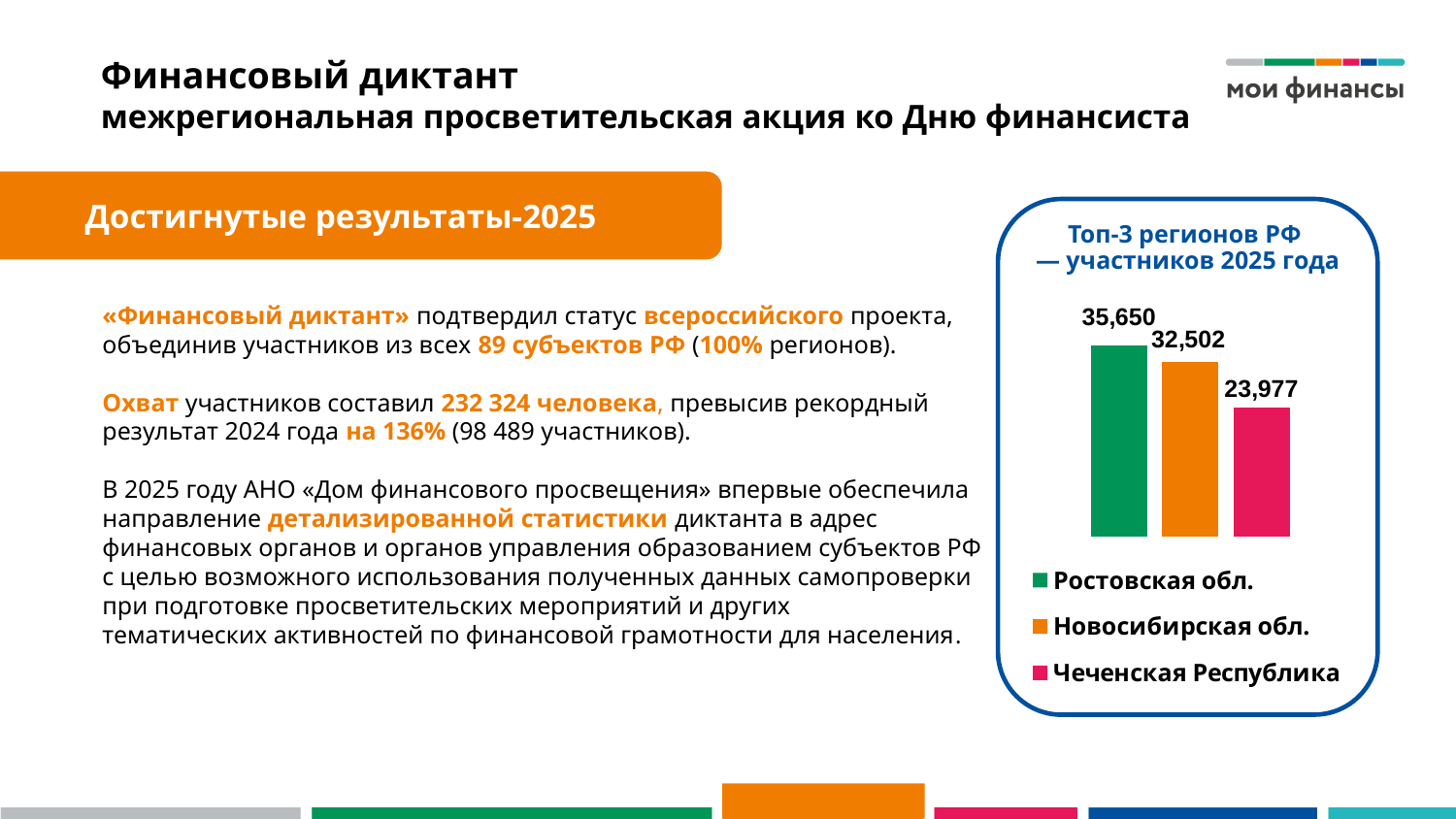
What is the number of participants for Новосибирская обл.? 32,502 What is the difference between the values for Новосибирская обл. and Чеченская Республика? 8,525 What type of chart is shown on the slide? Bar chart What is the number of participants for Ростовская обл.? 35,650 What is the difference between the values for Ростовская обл. and Новосибирская обл.? 3,148 Which is larger: the value for Новосибирская обл. or Чеченская Республика? Новосибирская обл. How many regions are shown in the chart? 3 What is the title of the chart? Топ-3 регионов РФ — участников 2025 года What is the number of participants for Чеченская Республика? 23,977 Which region has the highest number of participants? Ростовская обл. How many entries does the chart legend list? 3 Which region has the lowest number of participants? Чеченская Республика